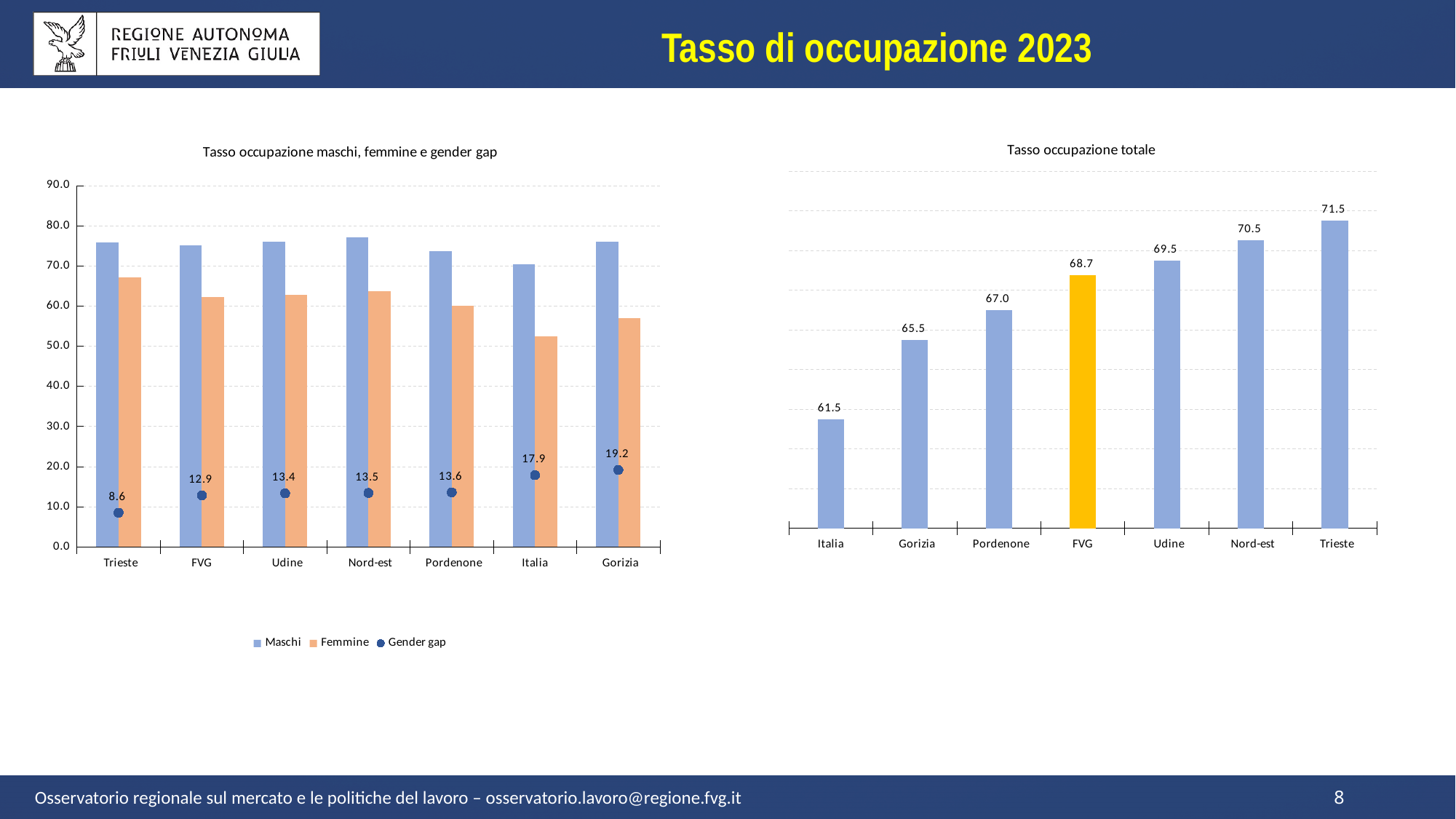
In the chart titled "Tasso occupazione maschi, femmine e gender gap", which category has the highest Gender gap? Gorizia In the chart titled "Tasso occupazione maschi, femmine e gender gap", is the Femmine value for Italia greater or less than 60.0? less In the chart titled "Tasso occupazione totale", which category has the lowest value? Italia In the chart titled "Tasso occupazione totale", what is the difference between the values for Trieste and Italia? 10.0 In the chart titled "Tasso occupazione maschi, femmine e gender gap", is the Maschi value for Nord-est greater or less than 70.0? greater In the chart titled "Tasso occupazione totale", do the values rise or fall from left to right along the x axis? rise In the chart titled "Tasso occupazione maschi, femmine e gender gap", what is the difference between the Gender gap for Italia and the Gender gap for FVG? 5.0 How many series does the legend of the chart titled "Tasso occupazione maschi, femmine e gender gap" list? 3 In the chart titled "Tasso occupazione totale", what is the value for FVG? 68.7 In the chart titled "Tasso occupazione totale", which is larger, the value for Udine or the value for Pordenone? Udine In the chart titled "Tasso occupazione totale", which category's bar is coloured yellow instead of blue? FVG In the chart titled "Tasso occupazione maschi, femmine e gender gap", what is the Gender gap value for Trieste? 8.6